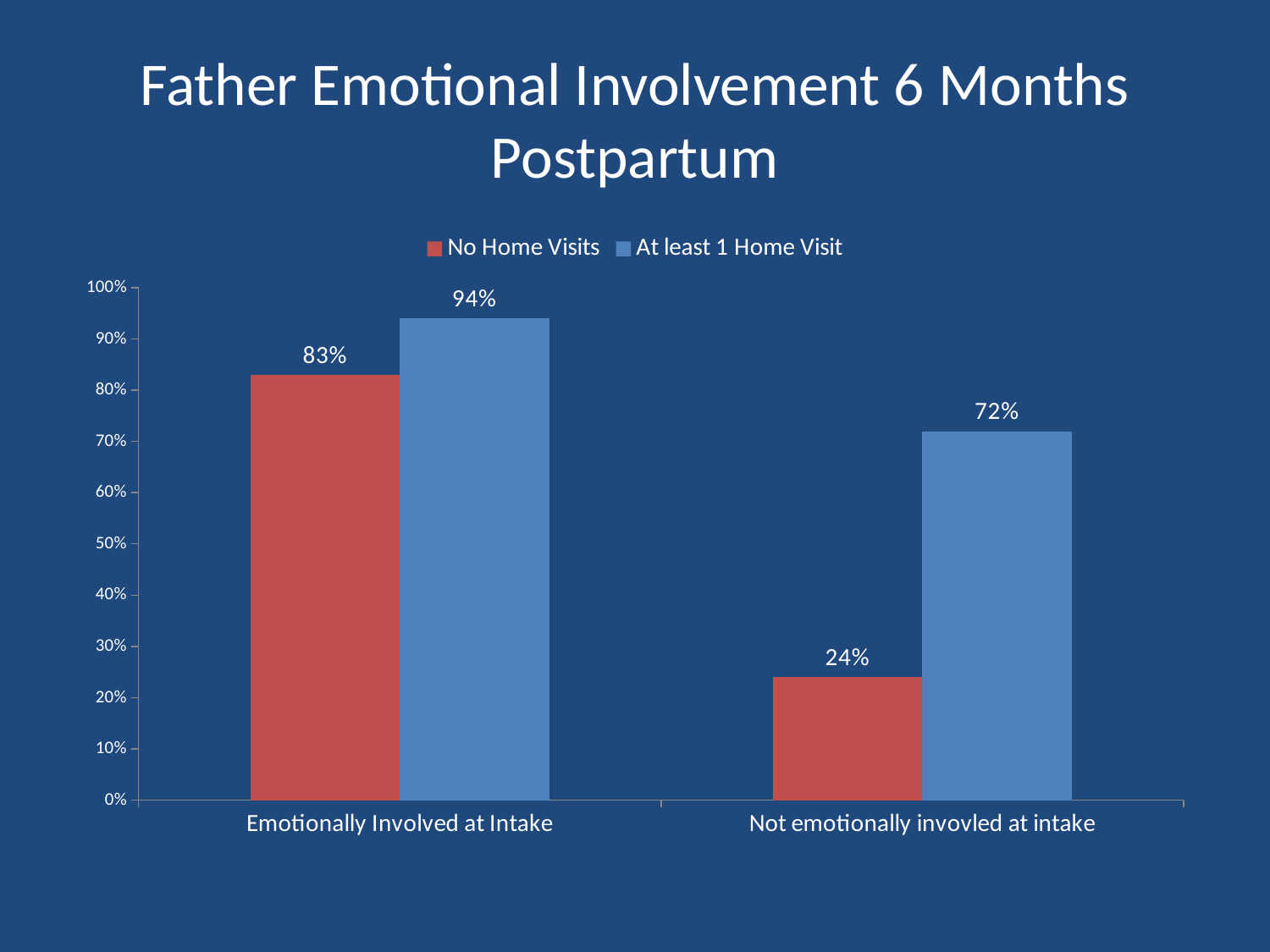
How many series does the legend list? 2 Which is larger: No Home Visits for Emotionally Involved at Intake or At least 1 Home Visit for Not emotionally invovled at intake? No Home Visits for Emotionally Involved at Intake How many categories are shown on the x axis? 2 Which bar has the highest value on the chart? At least 1 Home Visit, Emotionally Involved at Intake (94%) What is the value for No Home Visits in the Not emotionally invovled at intake category? 24% What is the title of the chart? Father Emotional Involvement 6 Months Postpartum What is the value for At least 1 Home Visit in the Not emotionally invovled at intake category? 72% Which bar has the lowest value on the chart? No Home Visits, Not emotionally invovled at intake (24%) What is the difference between At least 1 Home Visit and No Home Visits in the Emotionally Involved at Intake category? 11% What kind of chart is shown on the slide? Bar chart What is the value for No Home Visits in the Emotionally Involved at Intake category? 83% What is the difference between At least 1 Home Visit and No Home Visits in the Not emotionally invovled at intake category? 48%